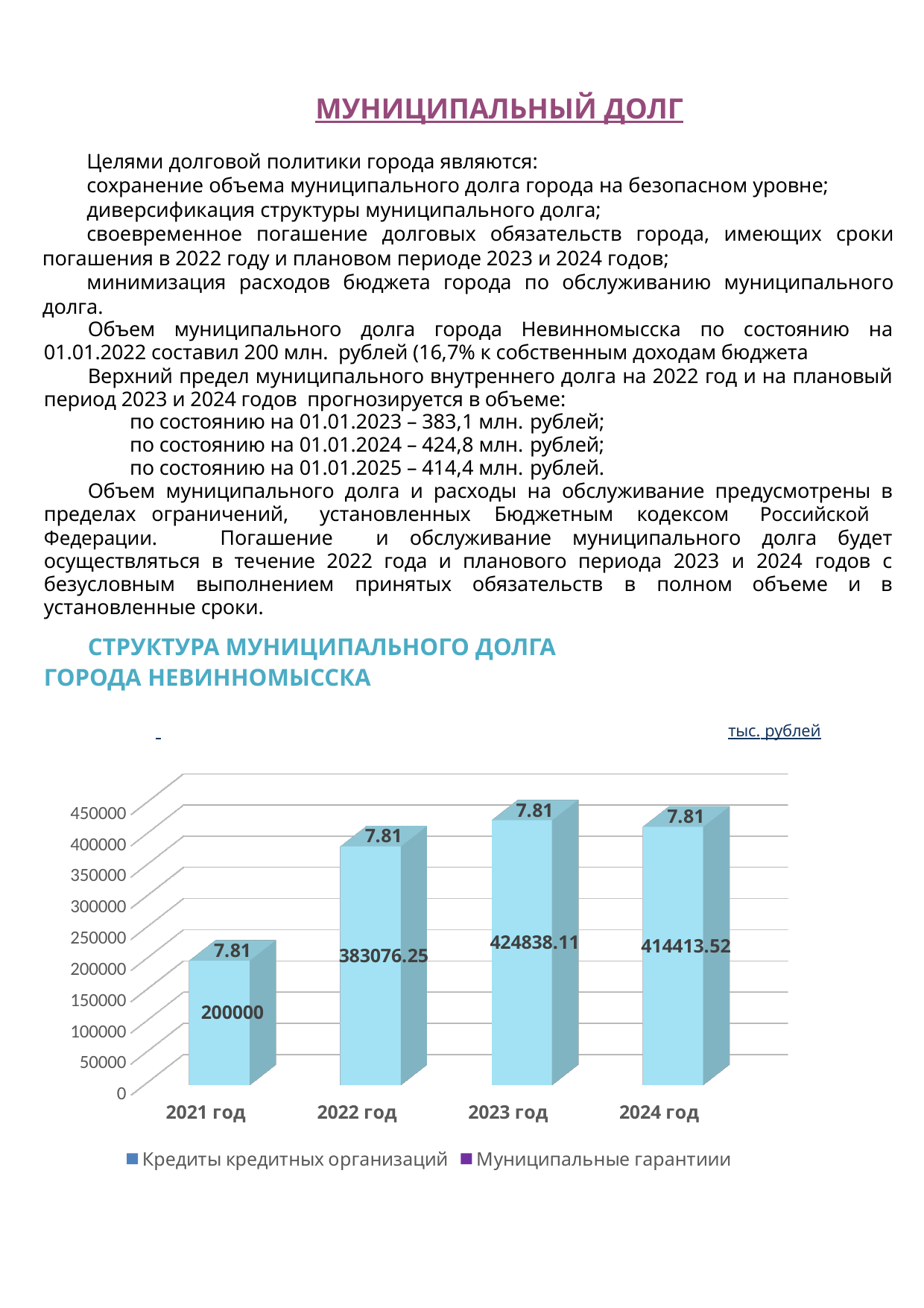
What is the value for Муниципальные гарантиии in 2022 год? 7.81 What kind of chart is shown? Bar chart How many years are shown on the x axis? 4 Which year has the lowest value for Кредиты кредитных организаций? 2021 год What unit is indicated above the chart? тыс. рублей Which is larger, the Кредиты кредитных организаций value for 2023 год or for 2024 год? 2023 год What is the value for Кредиты кредитных организаций in 2023 год? 424838.11 What is the value for Кредиты кредитных организаций in 2021 год? 200000 Which year has the highest value for Кредиты кредитных организаций? 2023 год How many series does the legend list? 2 What is the difference between the Кредиты кредитных организаций values for 2023 год and 2022 год? 41761.86 What is the total of the stacked bar for 2024 год? 414421.33